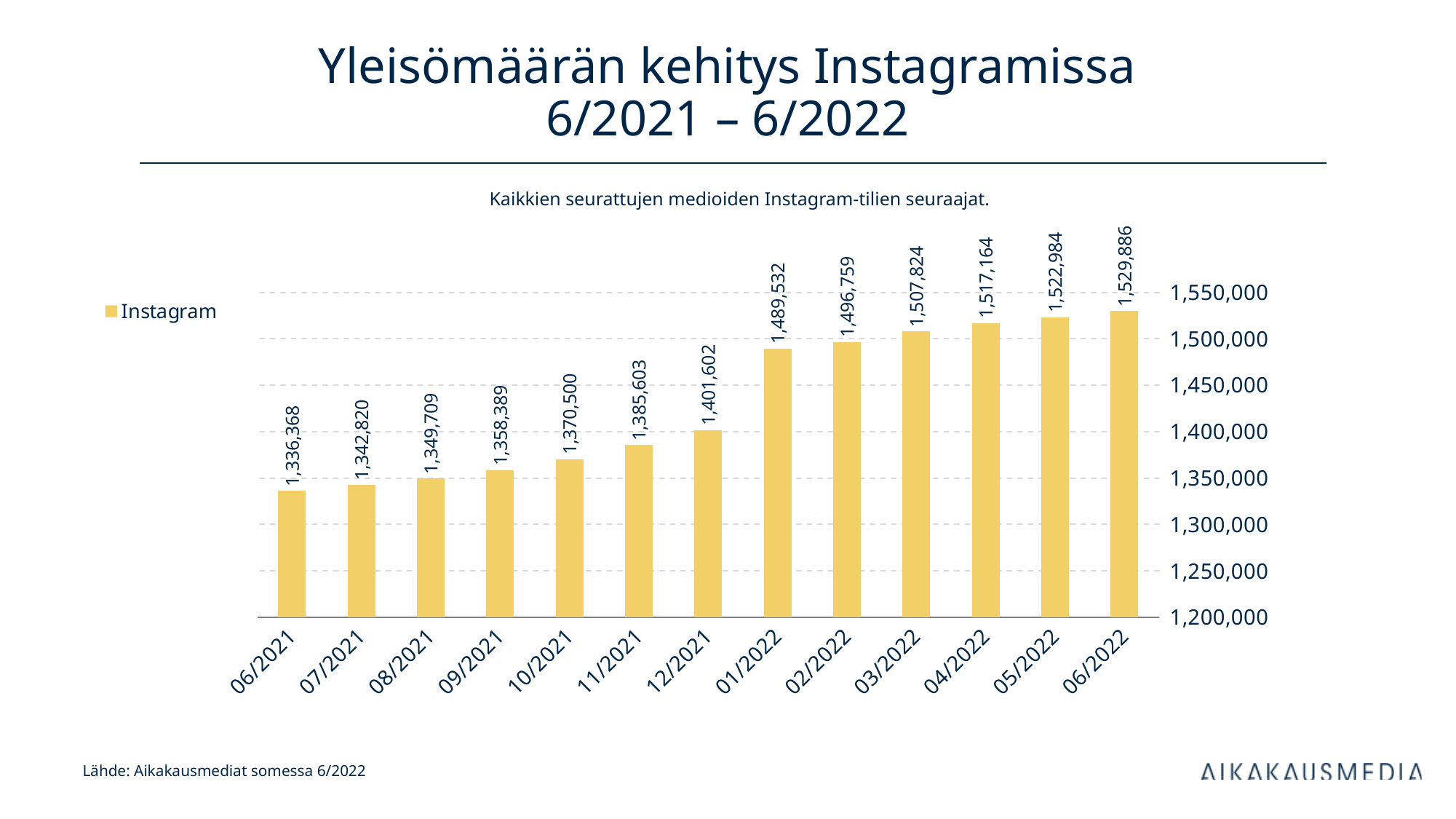
What is the difference between the values for 01/2022 and 12/2021? 87,930 What is the value for 06/2021? 1,336,368 How many months are shown on the x axis? 13 Which month has the highest value? 06/2022 What is the difference between the values for 06/2022 and 06/2021? 193,518 Is the value for 10/2021 greater or less than 1,400,000? less What is the value for 06/2022? 1,529,886 What kind of chart is shown on the slide? bar chart What is the value for 01/2022? 1,489,532 Which is larger, the value for 12/2021 or the value for 01/2022? 01/2022 Which month has the lowest value? 06/2021 Do the values rise or fall from 06/2021 to 06/2022? rise